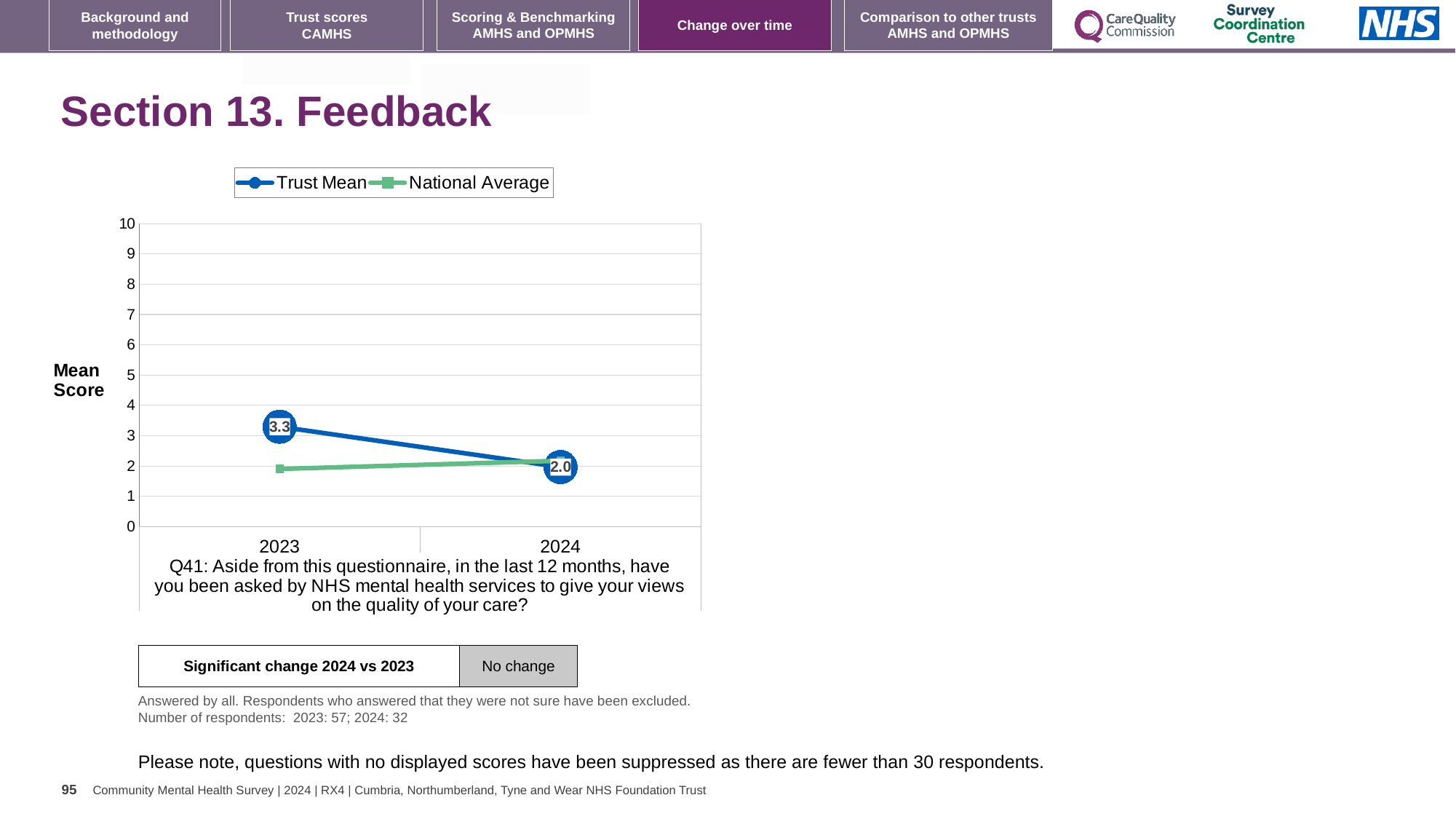
How many years are plotted on the x axis? 2 What kind of chart is shown on the slide? line chart What is the Trust Mean value for 2023? 3.3 What are the two series named in the legend? Trust Mean and National Average In 2023, which is larger: the Trust Mean or the National Average? Trust Mean In which year is the Trust Mean highest? 2023 What is the Trust Mean value for 2024? 2.0 What is the label on the y axis of the chart? Mean Score Is the National Average value for 2023 greater or less than 3? less By how much did the Trust Mean change from 2023 to 2024? 1.3 How many series does the legend list? 2 Does the Trust Mean rise or fall from 2023 to 2024? fall